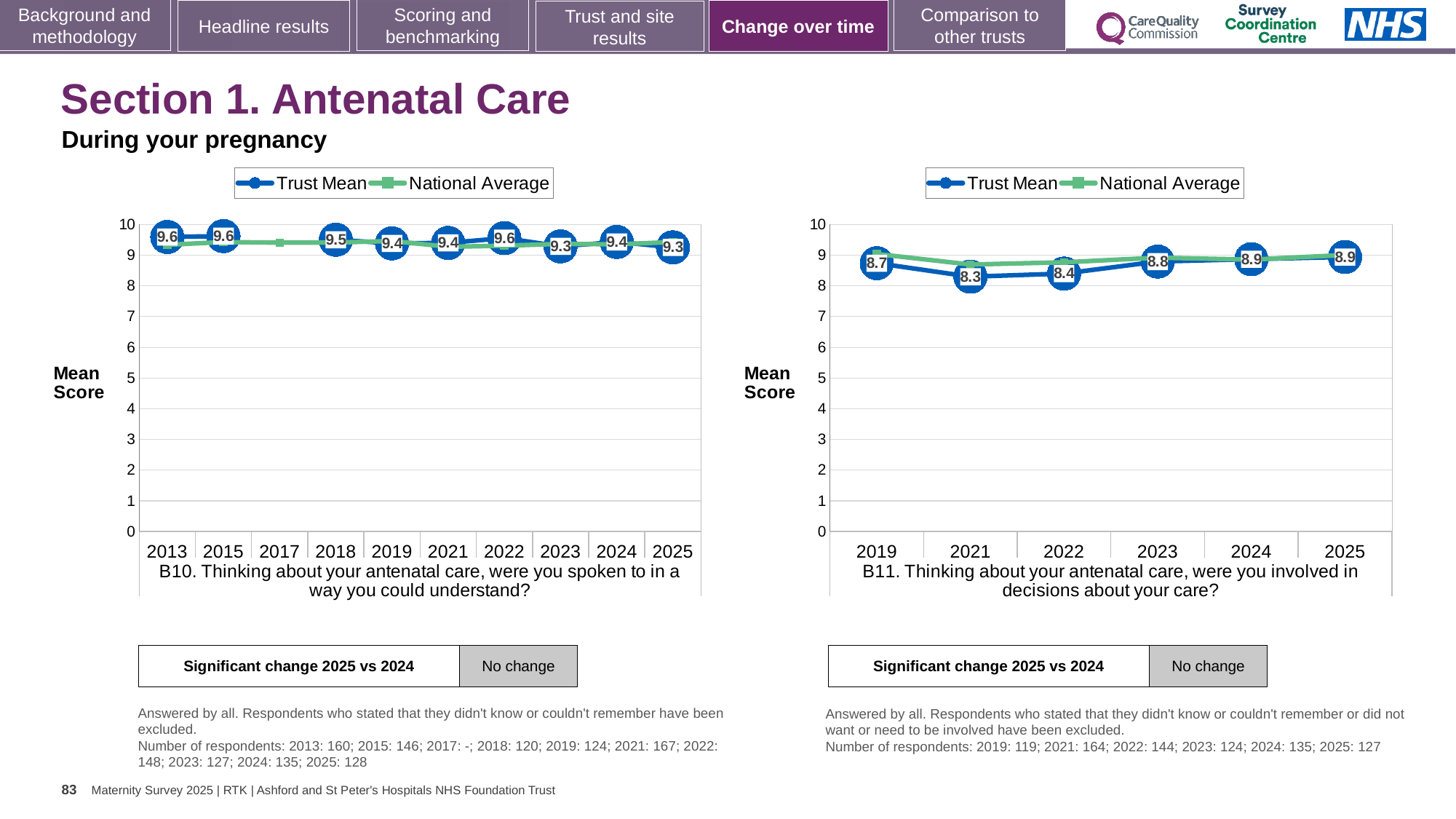
How many years are shown on the x axis of the left chart (B10)? 10 What kind of chart is the left chart (B10)? Line chart In the right chart (B11), is the Trust Mean score for 2021 greater or less than 9? less In the left chart (B10), which year has the larger Trust Mean score, 2022 or 2023? 2022 What does the 'Significant change 2025 vs 2024' box below the right chart (B11) say? No change In the right chart (B11), what is the difference between the Trust Mean scores for 2019 and 2021? 0.4 In the left chart (B10), what is the difference between the Trust Mean scores for 2013 and 2025? 0.3 In the right chart (B11), what is the Trust Mean score for 2023? 8.8 In the right chart (B11), which year has the lowest Trust Mean score? 2021 How many series does the legend of the right chart (B11) list? 2 In the right chart (B11), does the Trust Mean score rise or fall from 2021 to 2025? Rise In the left chart (B10), what is the Trust Mean score for 2018? 9.5